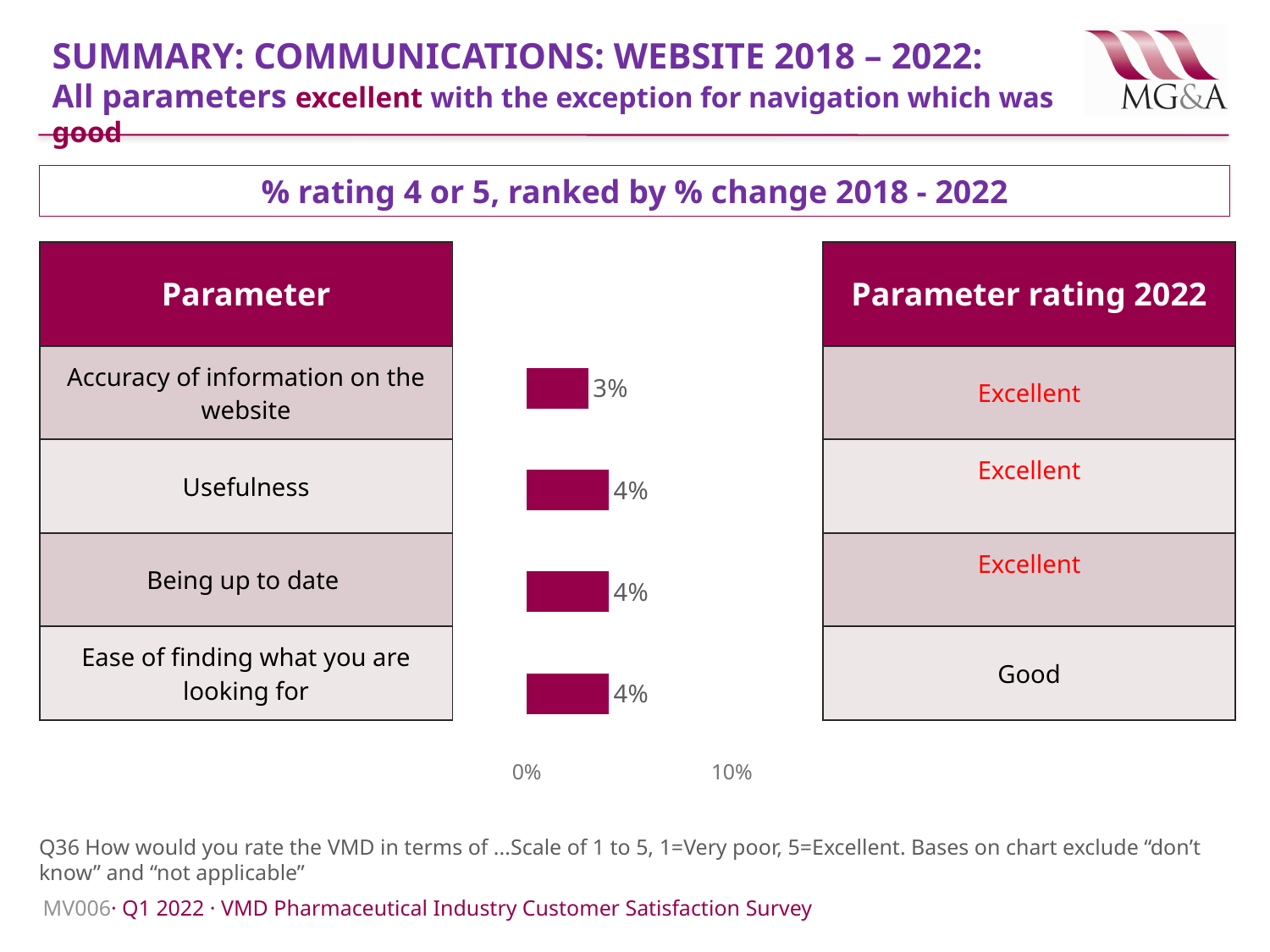
Which parameter has the lowest % change value on the chart? Accuracy of information on the website What is the % change value shown for Ease of finding what you are looking for? 4% Is the value for Ease of finding what you are looking for greater or less than 10%? less What is the % change value shown for Accuracy of information on the website? 3% What is the % change value shown for Being up to date? 4% What is the % change value shown for Usefulness? 4% Which is larger, the value for Being up to date or the value for Accuracy of information on the website? Being up to date What is the 2022 parameter rating shown for Ease of finding what you are looking for? Good How many parameters are plotted on the chart? 4 What is the title of the chart? % rating 4 or 5, ranked by % change 2018 - 2022 What is the difference between the values for Usefulness and Accuracy of information on the website? 1% What kind of chart is shown on the slide? bar chart